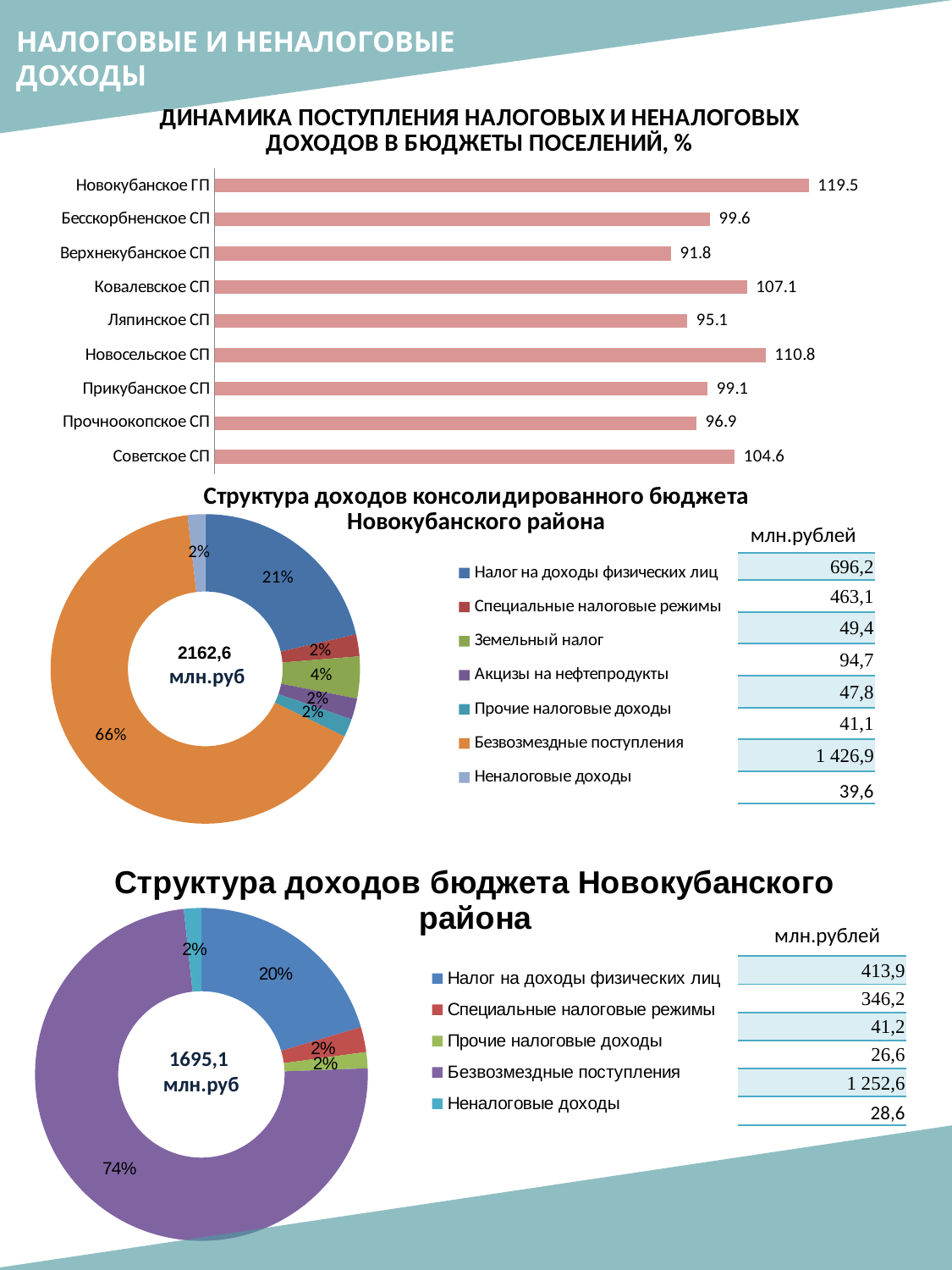
In the bar chart 'Динамика поступления налоговых и неналоговых доходов в бюджеты поселений, %', what is the difference between Новосельское СП and Ковалевское СП? 3.7 In the bar chart 'Динамика поступления налоговых и неналоговых доходов в бюджеты поселений, %', which category has the lowest value? Верхнекубанское СП In the doughnut chart 'Структура доходов бюджета Новокубанского района', what share is Налог на доходы физических лиц? 20% In the bar chart 'Динамика поступления налоговых и неналоговых доходов в бюджеты поселений, %', what is the value for Ляпинское СП? 95.1 What total value is shown in the centre of the doughnut chart 'Структура доходов бюджета Новокубанского района'? 1695,1 млн.руб In the doughnut chart 'Структура доходов консолидированного бюджета Новокубанского района', what share is Безвозмездные поступления? 66% What type of chart is 'Динамика поступления налоговых и неналоговых доходов в бюджеты поселений, %'? Bar chart In the bar chart 'Динамика поступления налоговых и неналоговых доходов в бюджеты поселений, %', which is larger: Советское СП or Прочноокопское СП? Советское СП In the bar chart 'Динамика поступления налоговых и неналоговых доходов в бюджеты поселений, %', what is the value for Новокубанское ГП? 119.5 How many series does the legend list in the doughnut chart 'Структура доходов консолидированного бюджета Новокубанского района'? 7 How many categories are shown in the bar chart 'Динамика поступления налоговых и неналоговых доходов в бюджеты поселений, %'? 9 In the bar chart 'Динамика поступления налоговых и неналоговых доходов в бюджеты поселений, %', which category has the highest value? Новокубанское ГП